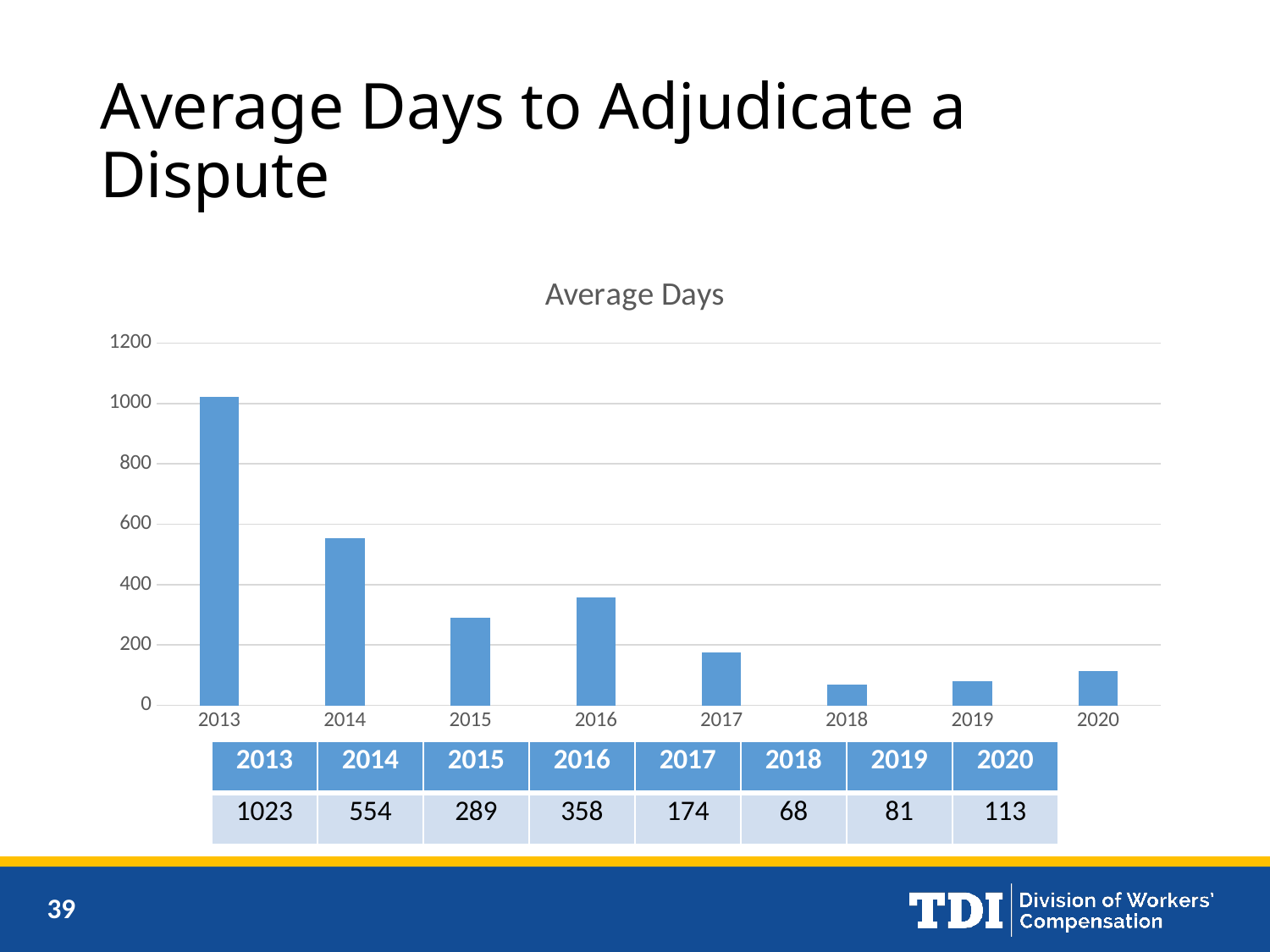
Which year has the highest average days to adjudicate a dispute? 2013 Which year has the lowest average days to adjudicate a dispute? 2018 What is the average days value for 2020? 113 Is the value for 2017 greater or less than 200? less What is the average days value for 2013? 1023 What is the difference in average days between 2016 and 2015? 69 What kind of chart is shown on the slide? Bar chart What is the difference in average days between 2013 and 2014? 469 What is the average days value for 2018? 68 What is the title of the chart? Average Days Which year has a larger average days value, 2015 or 2016? 2016 How many years are shown on the chart? 8